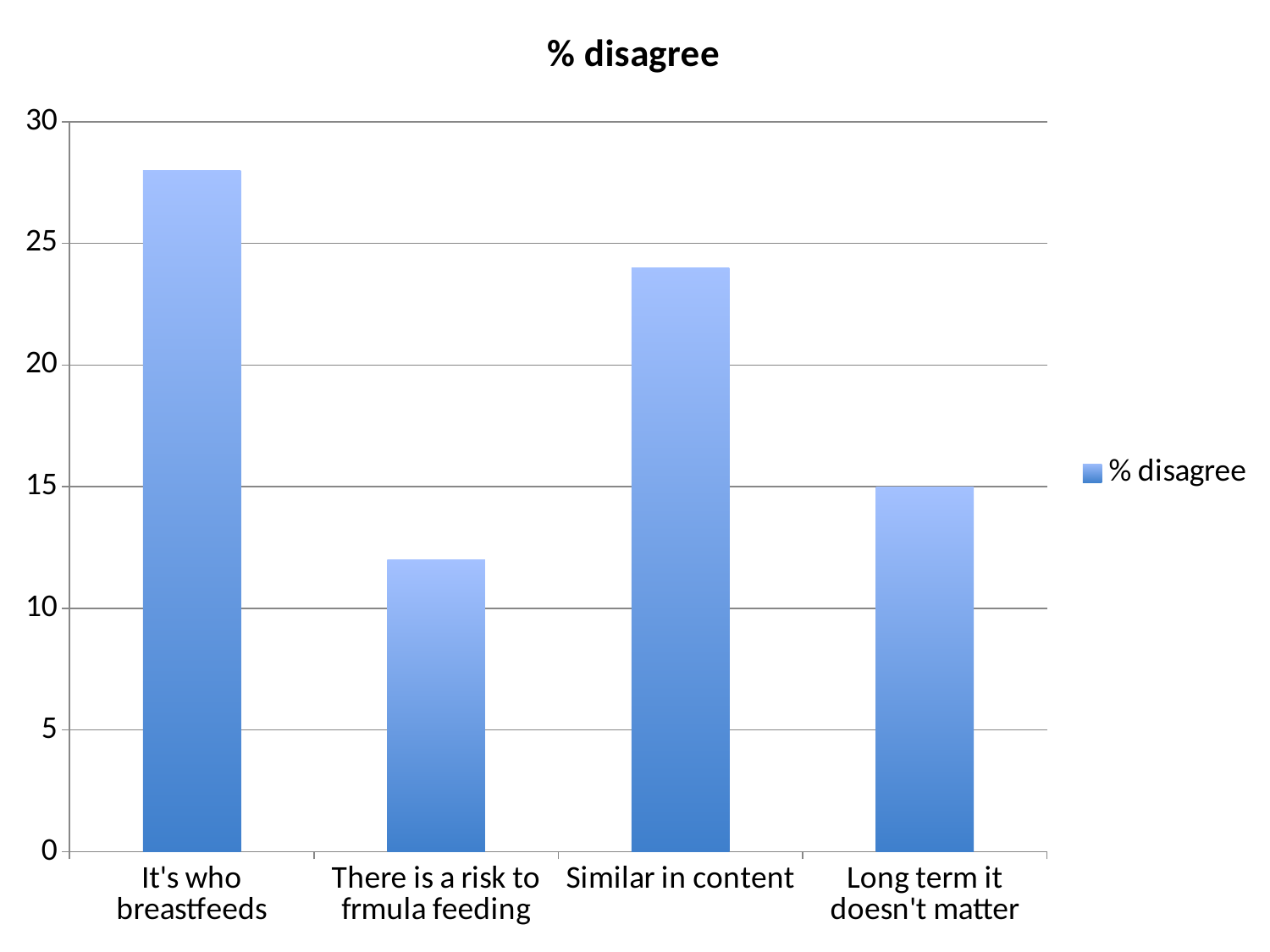
How many series does the legend list? 1 How many categories are shown on the x axis? 4 Which category has the lowest % disagree? There is a risk to frmula feeding Which is larger, the value for 'It's who breastfeeds' or the value for 'There is a risk to frmula feeding'? It's who breastfeeds What is the % disagree value for 'Long term it doesn't matter'? 15 What is the title of the chart? % disagree Is the value for 'Similar in content' greater or less than 20? greater What kind of chart is shown on the slide? bar chart Is the value for 'There is a risk to frmula feeding' greater or less than 15? less Which is larger, the value for 'Similar in content' or the value for 'Long term it doesn't matter'? Similar in content Is the value for 'It's who breastfeeds' greater or less than 25? greater Which category has the highest % disagree? It's who breastfeeds